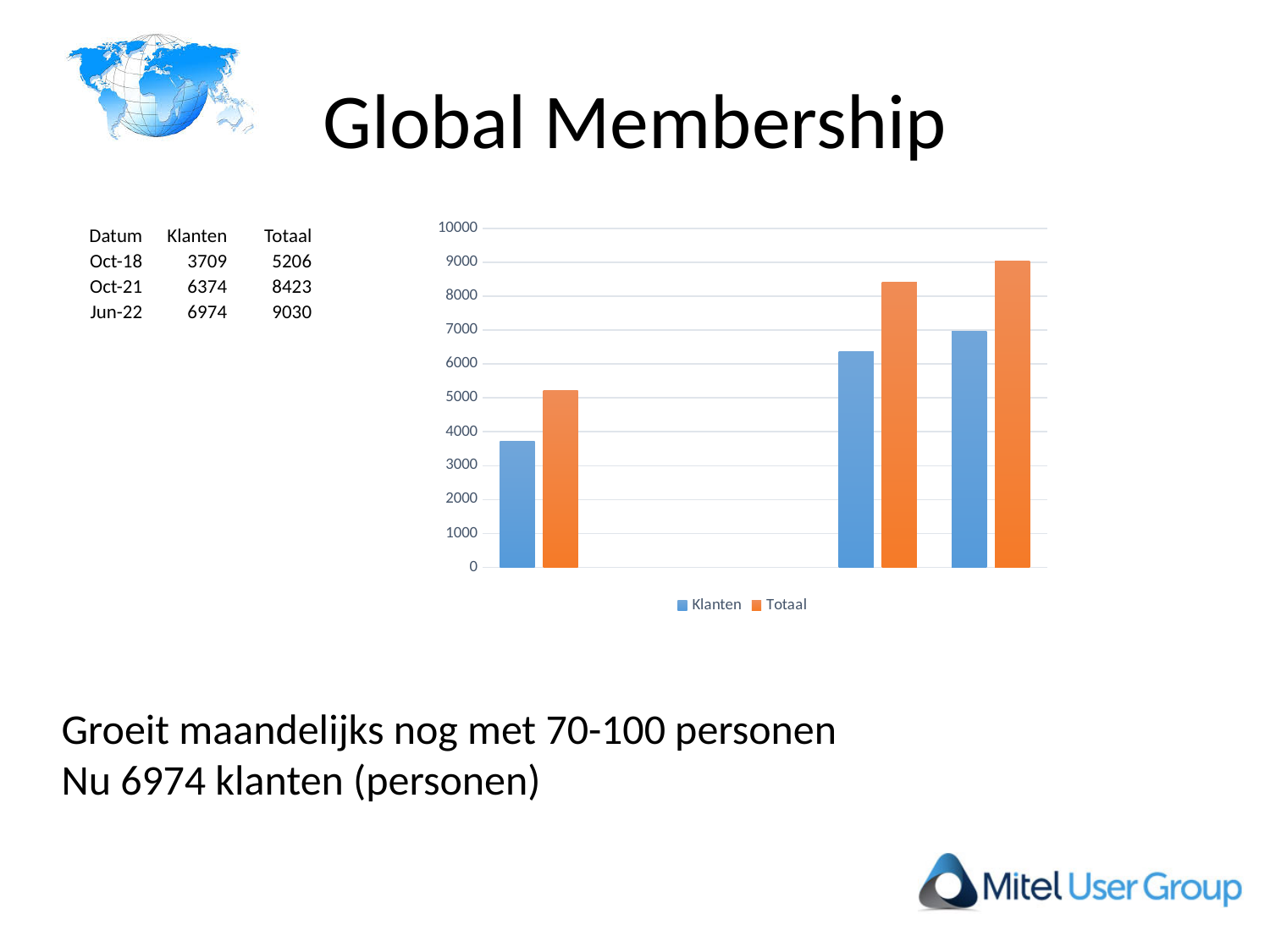
How many series does the chart legend list? 2 Is the Klanten bar in the first (leftmost) group greater or less than 4000? less What kind of chart is shown on the slide? bar chart Which group of bars has the highest Totaal value? the rightmost group (Jun-22) In the middle group of bars, which is larger, Klanten or Totaal? Totaal How many groups of bars are plotted in the chart? 3 Which colour represents the Totaal series in the chart? orange Is the Totaal bar in the first (leftmost) group greater or less than 5000? greater Is the Klanten bar in the rightmost group greater or less than 7000? less Do the Klanten values rise or fall from left to right across the chart? rise What are the two series named in the chart legend? Klanten and Totaal